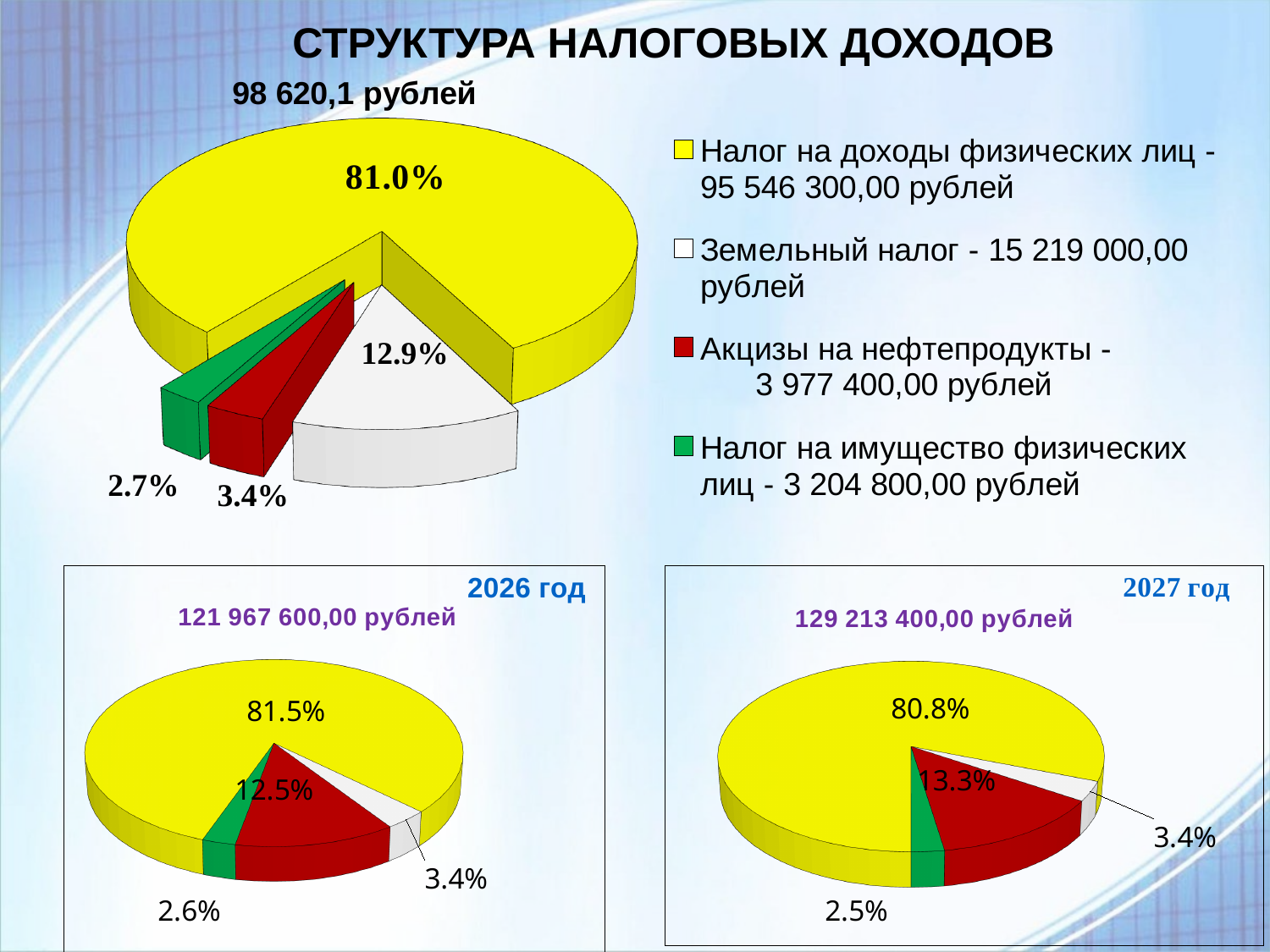
What kind of chart is used on this slide? Pie chart In the top pie chart, what share is labelled for the largest slice (Налог на доходы физических лиц)? 81.0% According to the legend of the top chart, what is the amount for Земельный налог? 15 219 000,00 рублей Which is larger: the largest slice in the 2026 год chart or the largest slice in the 2027 год chart? 2026 год (81.5%) What total amount is shown above the 2027 год chart? 129 213 400,00 рублей In the top pie chart, what percentage is shown for the green slice (Налог на имущество физических лиц)? 2.7% How many categories does the legend of the top chart list? 4 According to the legend of the top chart, what is the amount for Налог на доходы физических лиц? 95 546 300,00 рублей In the top pie chart, what percentage is shown for the red slice (Акцизы на нефтепродукты)? 3.4% In the 2026 год chart, what is the largest percentage shown? 81.5% In the 2027 год chart, what is the smallest percentage shown? 2.5%